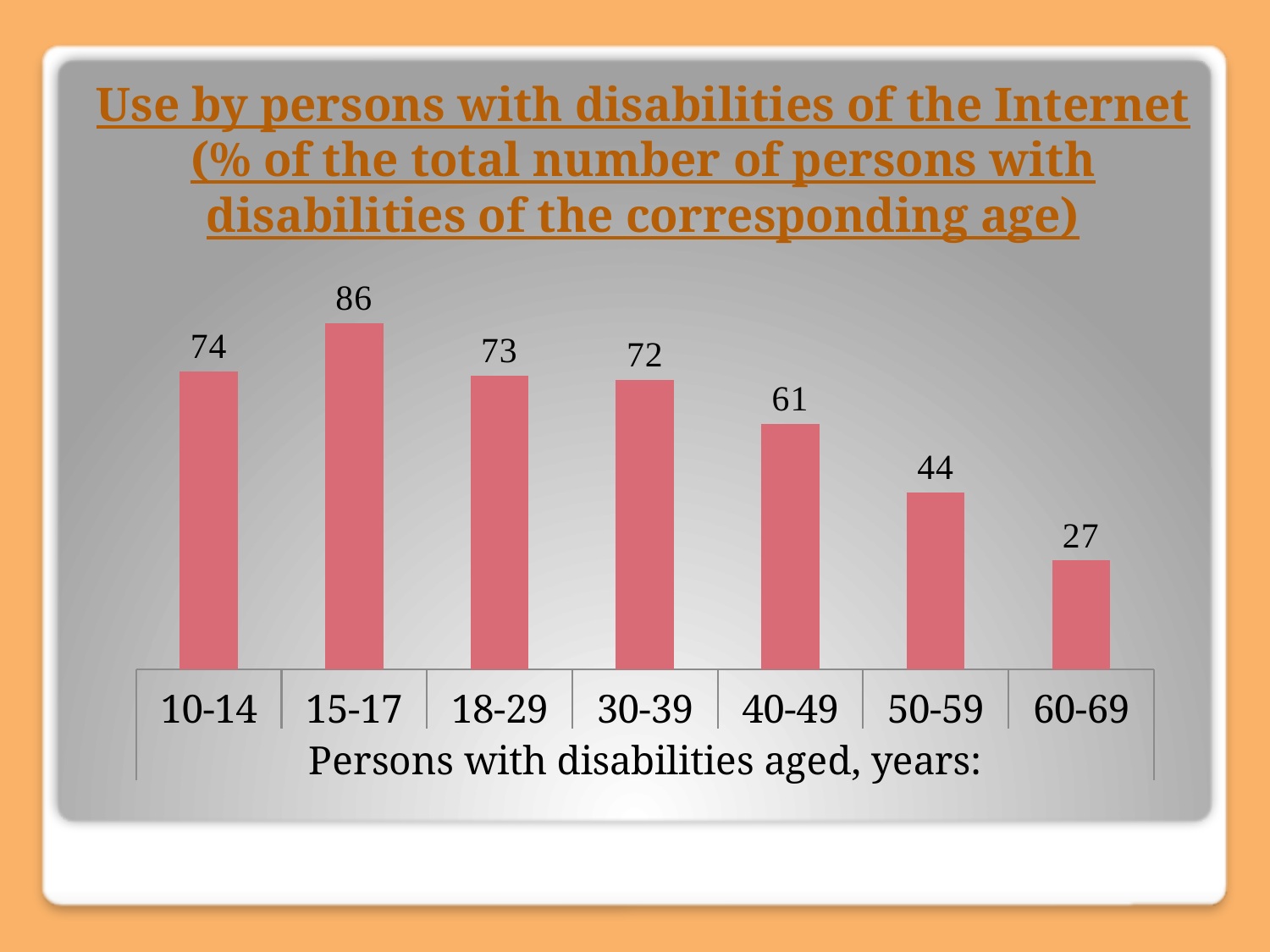
Do the values rise or fall from the 15-17 age group to the 60-69 age group? Fall Which age group has the highest value? 15-17 Which age group has the lowest value? 60-69 What is the difference between the values for the 15-17 and 60-69 age groups? 59 What is the x-axis title of the chart? Persons with disabilities aged, years: What is the value for the 10-14 age group? 74 How many age groups are shown on the chart? 7 What is the value for the 40-49 age group? 61 Which is larger, the value for 10-14 or the value for 30-39? 10-14 What kind of chart is shown on the slide? Bar chart What is the difference between the values for the 40-49 and 50-59 age groups? 17 What is the value for the 60-69 age group? 27